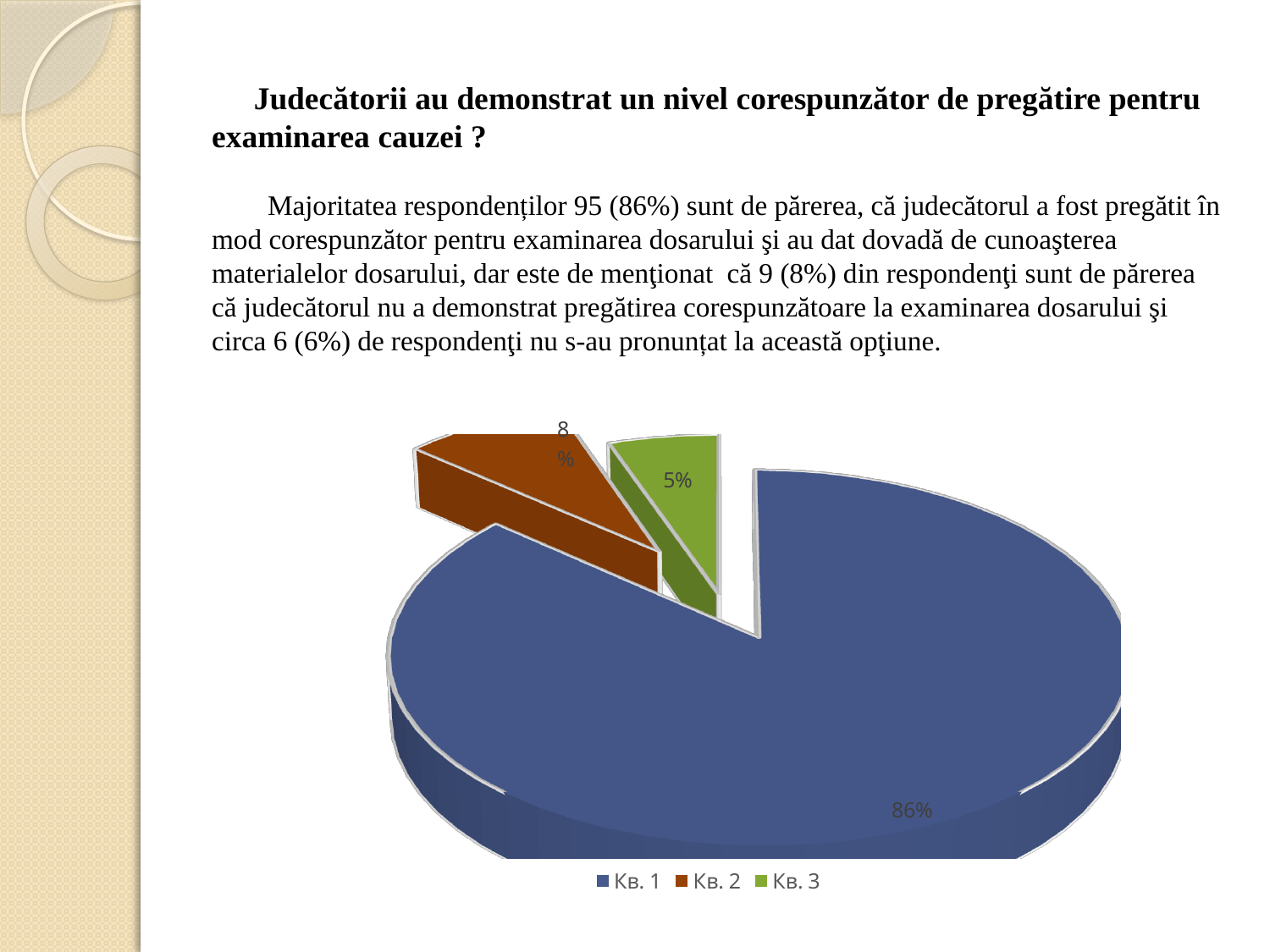
What share of the pie does the slice Кв. 3 represent? 5% Which slice of the pie chart is the largest? Кв. 1 How many entries does the legend of the pie chart list? 3 What colour is the Кв. 1 slice in the pie chart? blue How many slices does the pie chart have? 3 What share of the pie does the slice Кв. 2 represent? 8% What is the difference in percentage points between the Кв. 2 slice and the Кв. 3 slice? 3 What share of the pie does the slice Кв. 1 represent? 86% What kind of chart is shown on the slide? pie chart What is the difference in percentage points between the Кв. 1 slice and the Кв. 2 slice? 78 Which is larger in the pie chart, Кв. 2 or Кв. 3? Кв. 2 Which slice of the pie chart is the smallest? Кв. 3